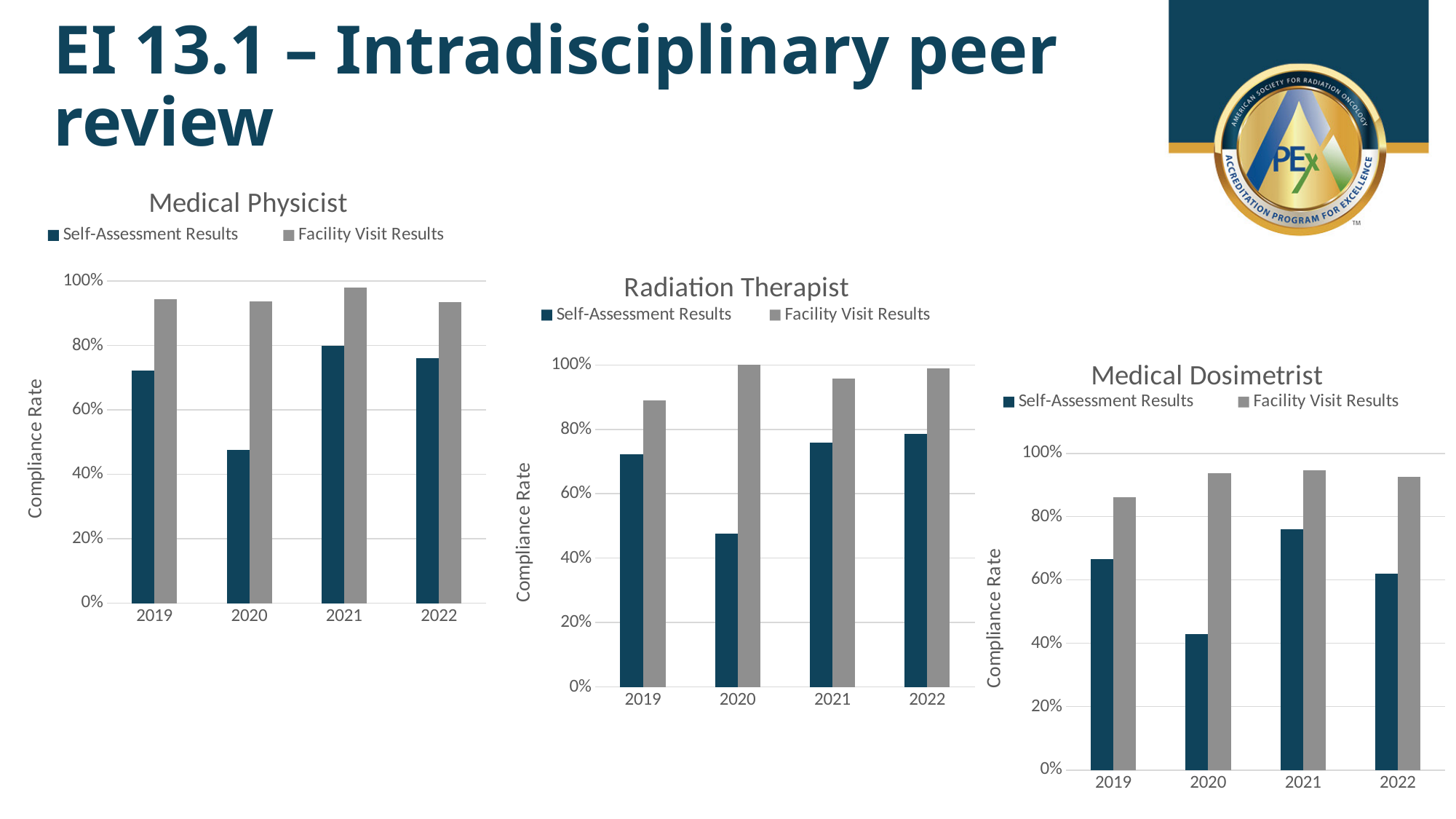
In the Medical Dosimetrist chart, is the Self-Assessment Results value for 2021 greater or less than 60%? greater In the Radiation Therapist chart, what is the Facility Visit Results value for 2020? 100% In the Medical Dosimetrist chart, which year has the lowest Self-Assessment Results value? 2020 In the Medical Physicist chart, is the Self-Assessment Results value for 2020 greater or less than 60%? less What kind of chart is the Medical Physicist chart? bar chart In the Radiation Therapist chart, which is larger for 2019: Self-Assessment Results or Facility Visit Results? Facility Visit Results In the Medical Dosimetrist chart, how many years are shown on the x axis? 4 What is the y-axis title of the Medical Dosimetrist chart? Compliance Rate In the Medical Physicist chart, which year has the lowest Self-Assessment Results value? 2020 In the Radiation Therapist chart, is the Self-Assessment Results value for 2020 greater or less than 60%? less In the Radiation Therapist chart, how many series does the legend list? 2 In the Medical Physicist chart, which year has the highest Facility Visit Results value? 2021